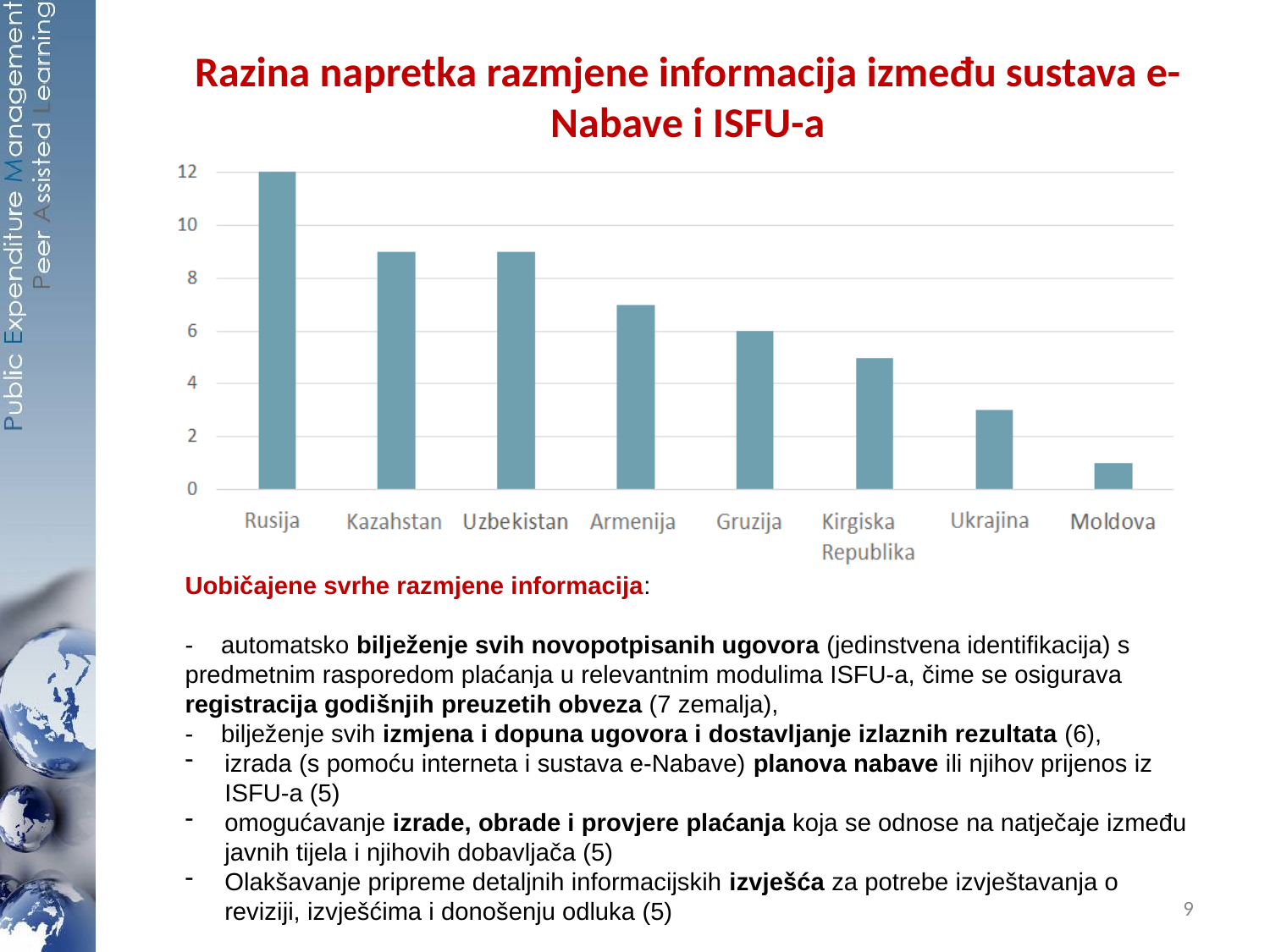
What kind of chart is shown on the slide? bar chart Do the values rise or fall from left to right along the x axis? fall Which country has the lowest bar? Moldova How many countries are shown on the x axis? 8 Is the value for Moldova greater or less than 2? less Is the value for Ukrajina greater or less than 4? less Which country has the highest bar? Rusija What is the value for Gruzija? 6 Is the value for Kazahstan greater or less than 8? greater Which has a larger value, Armenija or Ukrajina? Armenija What is the difference between the values for Rusija and Gruzija? 6 What is the value for Rusija? 12